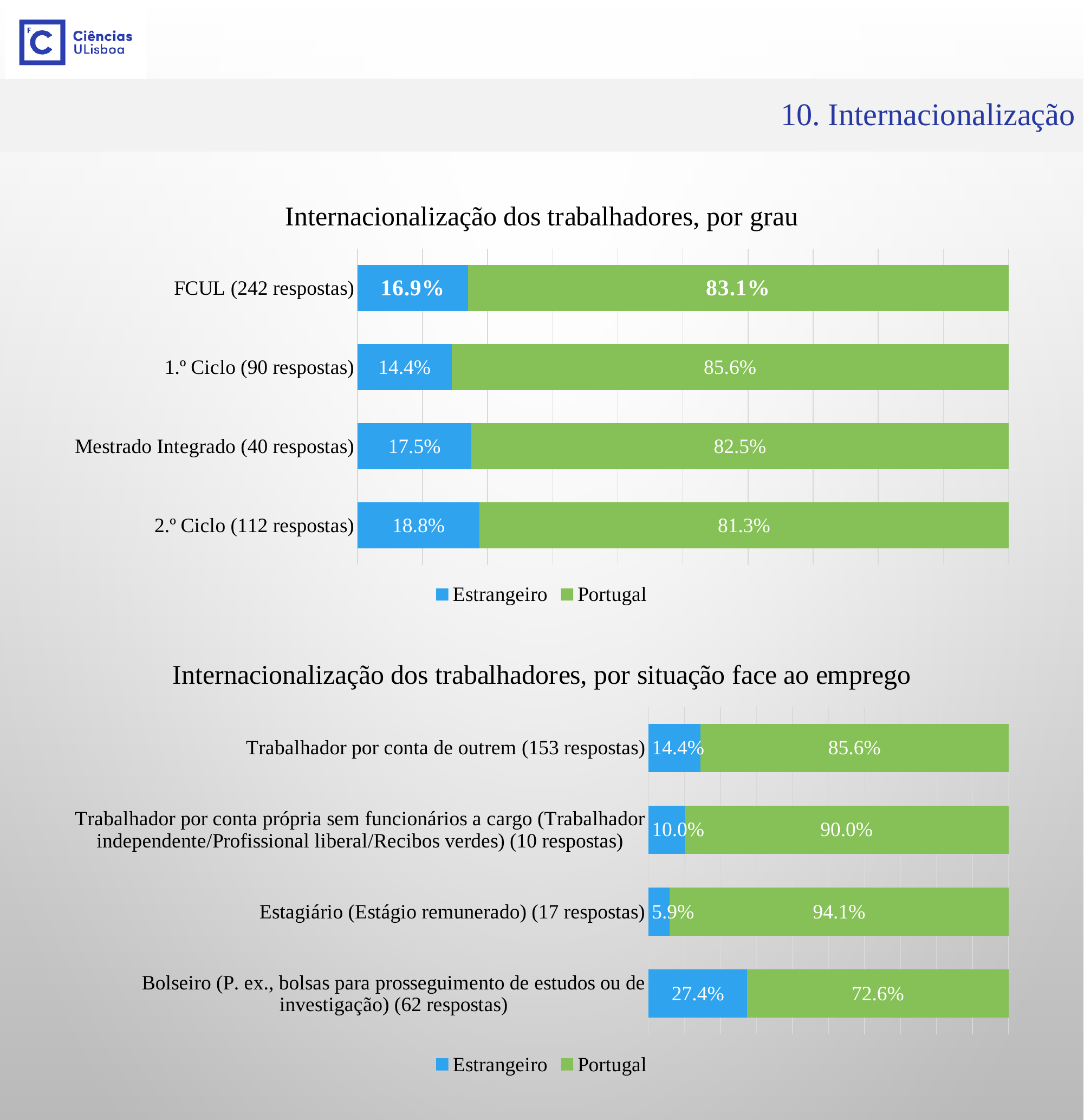
In the chart 'Internacionalização dos trabalhadores, por situação face ao emprego', what is the Portugal value for Estagiário (Estágio remunerado) (17 respostas)? 94.1% In the chart 'Internacionalização dos trabalhadores, por grau', which category has the lowest Estrangeiro value? 1.º Ciclo (90 respostas) In the chart 'Internacionalização dos trabalhadores, por grau', what is the Portugal value for Mestrado Integrado (40 respostas)? 82.5% In the chart 'Internacionalização dos trabalhadores, por grau', how many series does the legend list? 2 In the chart 'Internacionalização dos trabalhadores, por grau', which category has the highest Estrangeiro value? 2.º Ciclo (112 respostas) In the chart 'Internacionalização dos trabalhadores, por grau', what is the difference between the Portugal values for 1.º Ciclo and 2.º Ciclo? 4.3% In the chart 'Internacionalização dos trabalhadores, por situação face ao emprego', how many categories are shown? 4 In the chart 'Internacionalização dos trabalhadores, por situação face ao emprego', what is the Estrangeiro value for Bolseiro (62 respostas)? 27.4% What kind of chart is 'Internacionalização dos trabalhadores, por situação face ao emprego'? Stacked bar chart In the chart 'Internacionalização dos trabalhadores, por situação face ao emprego', which category has the lowest Estrangeiro value? Estagiário (Estágio remunerado) (17 respostas) In the chart 'Internacionalização dos trabalhadores, por grau', what is the Estrangeiro value for FCUL (242 respostas)? 16.9% In the chart 'Internacionalização dos trabalhadores, por situação face ao emprego', is the Estrangeiro value larger for Trabalhador por conta de outrem or for Bolseiro? Bolseiro